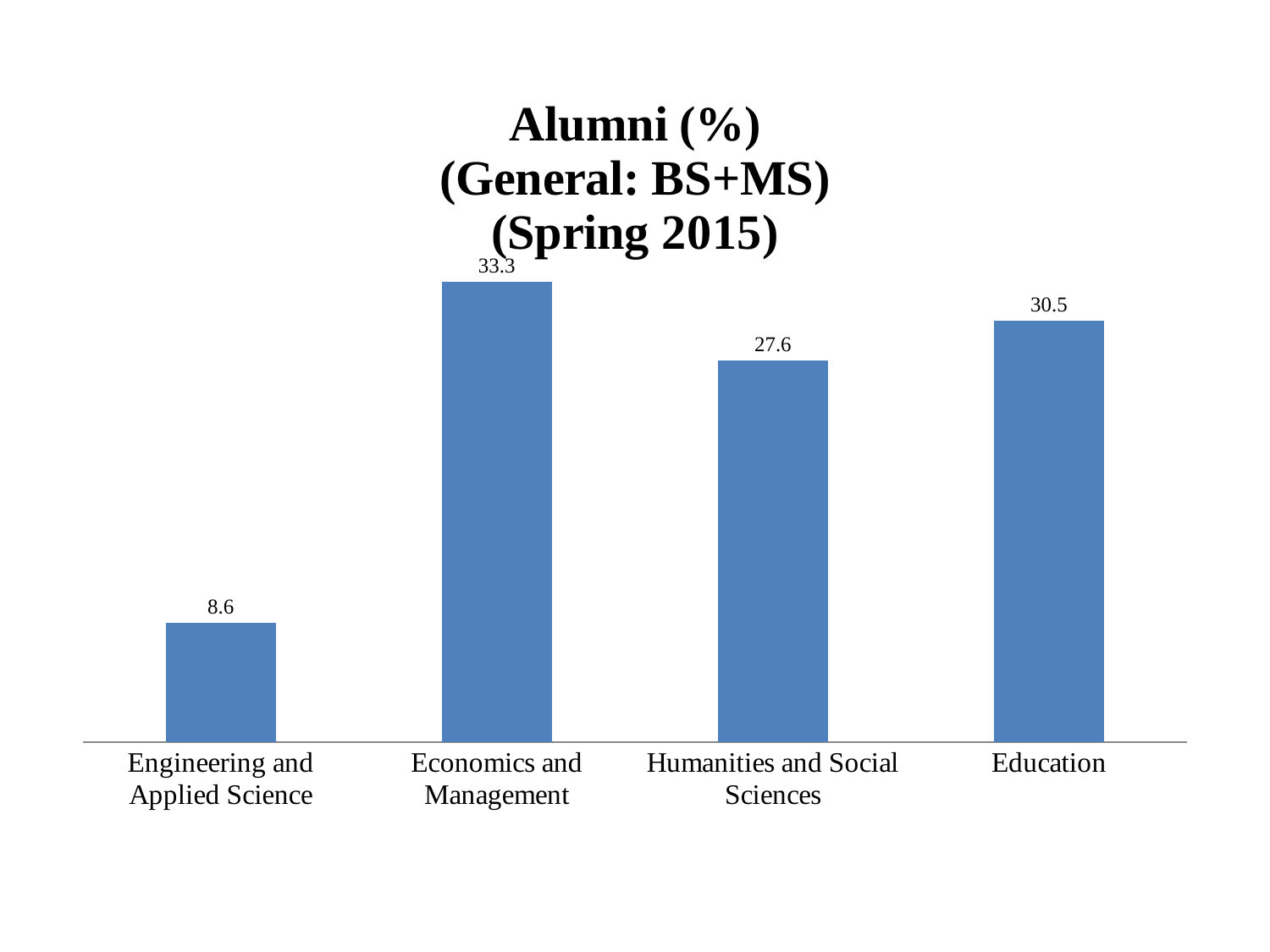
What is the value for Education? 30.5 What is the value for Engineering and Applied Science? 8.6 What is the value for Economics and Management? 33.3 What is the difference between the values for Economics and Management and Engineering and Applied Science? 24.7 Which is larger, the value for Education or the value for Humanities and Social Sciences? Education Which category has the lowest value? Engineering and Applied Science What kind of chart is shown on the slide? Bar chart What is the value for Humanities and Social Sciences? 27.6 What is the title of the chart? Alumni (%) (General: BS+MS) (Spring 2015) How many categories are shown in the chart? 4 What is the difference between the values for Education and Humanities and Social Sciences? 2.9 Which category has the highest value? Economics and Management